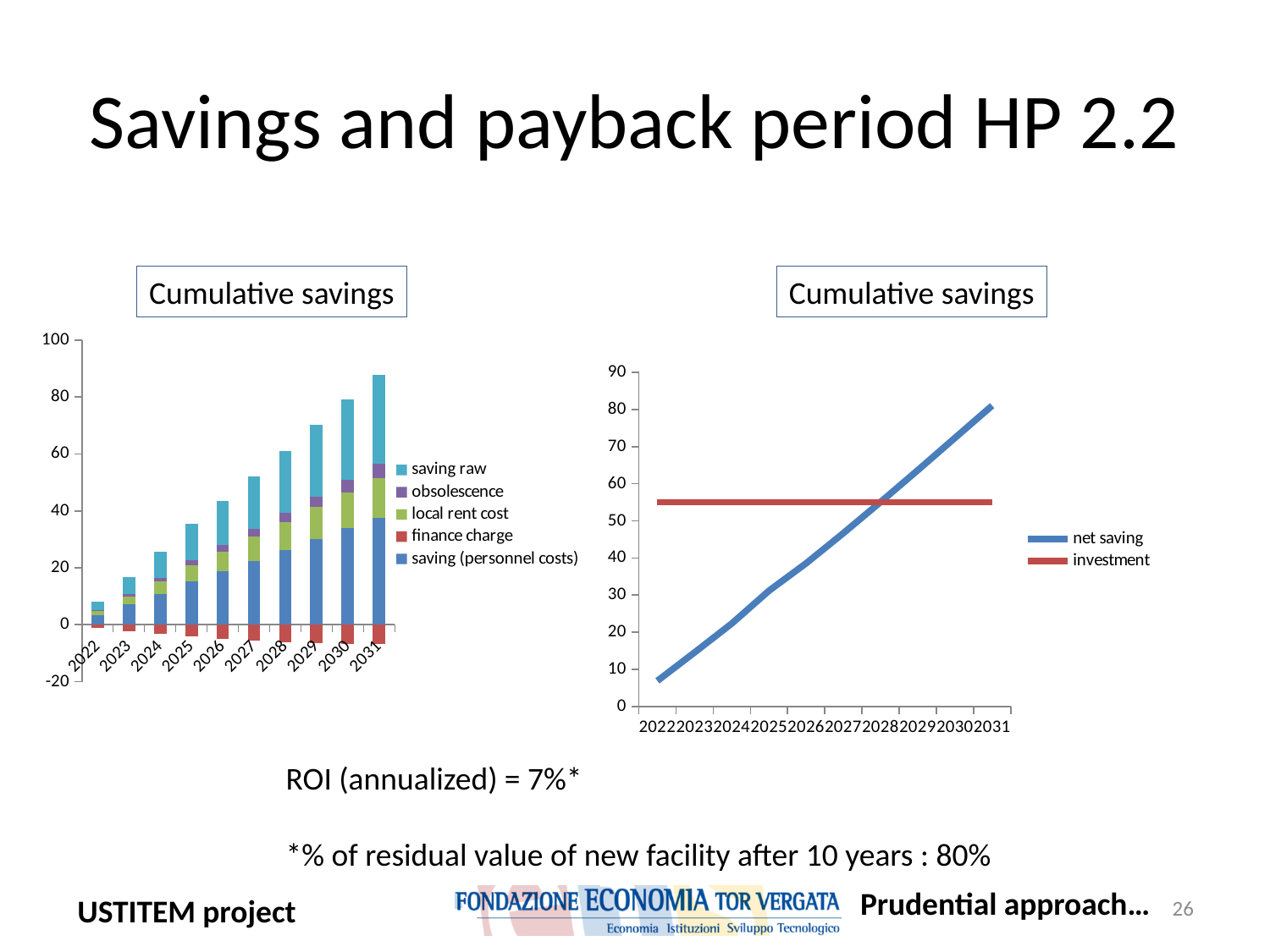
How many series does the legend of the right chart list? 2 In the left chart, is the total stacked value for 2022 greater or less than 20? less In the left chart, is the total stacked value for 2031 greater or less than 80? greater In the left chart, which year has the shortest stacked bar? 2022 In the right chart, does the net saving line rise or fall from 2022 to 2031? rise How many years are shown on the x axis of the left chart? 10 What kind of chart is the right chart on the slide? line chart In the right chart, is the investment value greater or less than 50? greater How many series does the legend of the left chart list? 5 What kind of chart is the left chart on the slide? stacked bar chart In the right chart, which series is drawn in red? investment In the left chart, which year has the tallest stacked bar? 2031